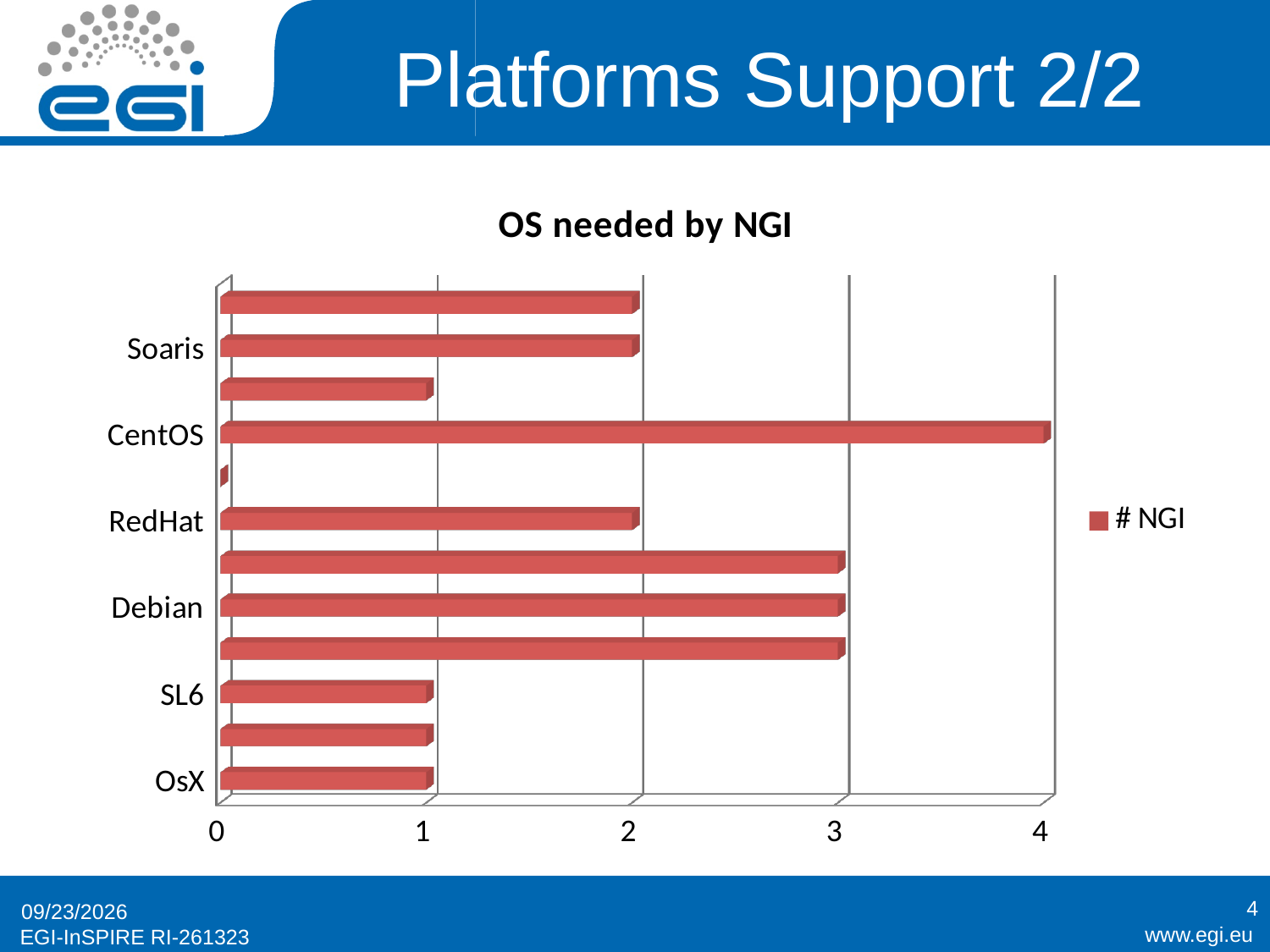
What is the difference between the # NGI values for CentOS and SL6? 3 What is the # NGI value for RedHat? 2 What is the name of the series shown in the legend? # NGI Is the # NGI value for Soaris greater or less than 3? less What is the title of the chart? OS needed by NGI What is the # NGI value for CentOS? 4 Which labelled OS has the highest # NGI value? CentOS What is the # NGI value for Debian? 3 How many series does the legend list? 1 What kind of chart is shown on the slide? bar chart Which has a larger # NGI value, Debian or Soaris? Debian What is the # NGI value for OsX? 1